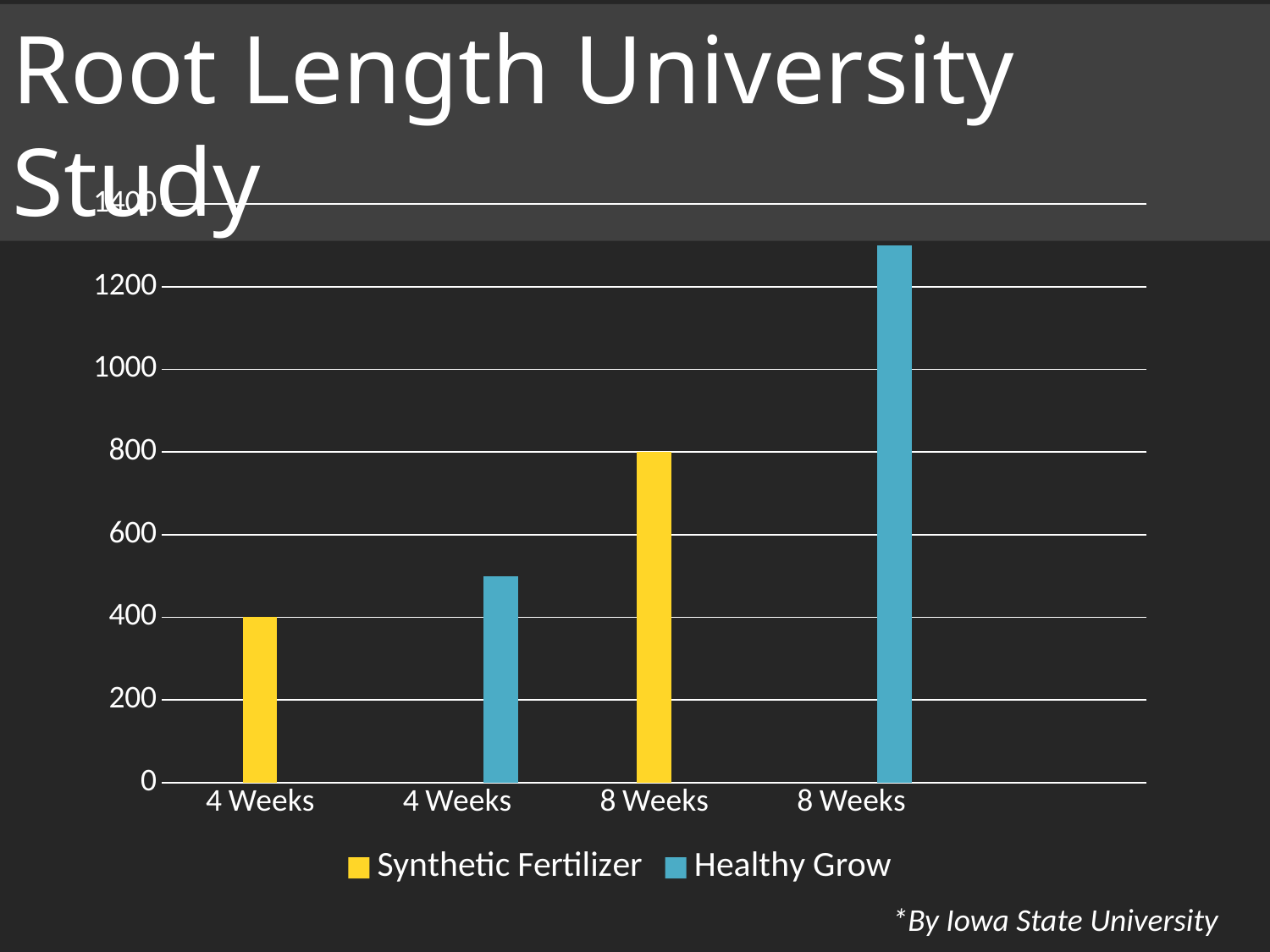
At 4 Weeks, which series has the larger value, Synthetic Fertilizer or Healthy Grow? Healthy Grow Which bar is the lowest in the chart? Synthetic Fertilizer at 4 Weeks What is the value of the Synthetic Fertilizer bar at 4 Weeks? 400 How many series does the legend list? 2 Which bar is the highest in the chart? Healthy Grow at 8 Weeks Is the value of the Healthy Grow bar at 8 Weeks greater or less than 1200? greater Is the value of the Healthy Grow bar at 4 Weeks greater or less than 400? greater What is the difference between the Synthetic Fertilizer values at 8 Weeks and 4 Weeks? 400 What kind of chart is shown on the slide? bar chart Do the bar values rise or fall from left to right across the chart? rise How many bars are plotted in the chart? 4 What is the value of the Synthetic Fertilizer bar at 8 Weeks? 800